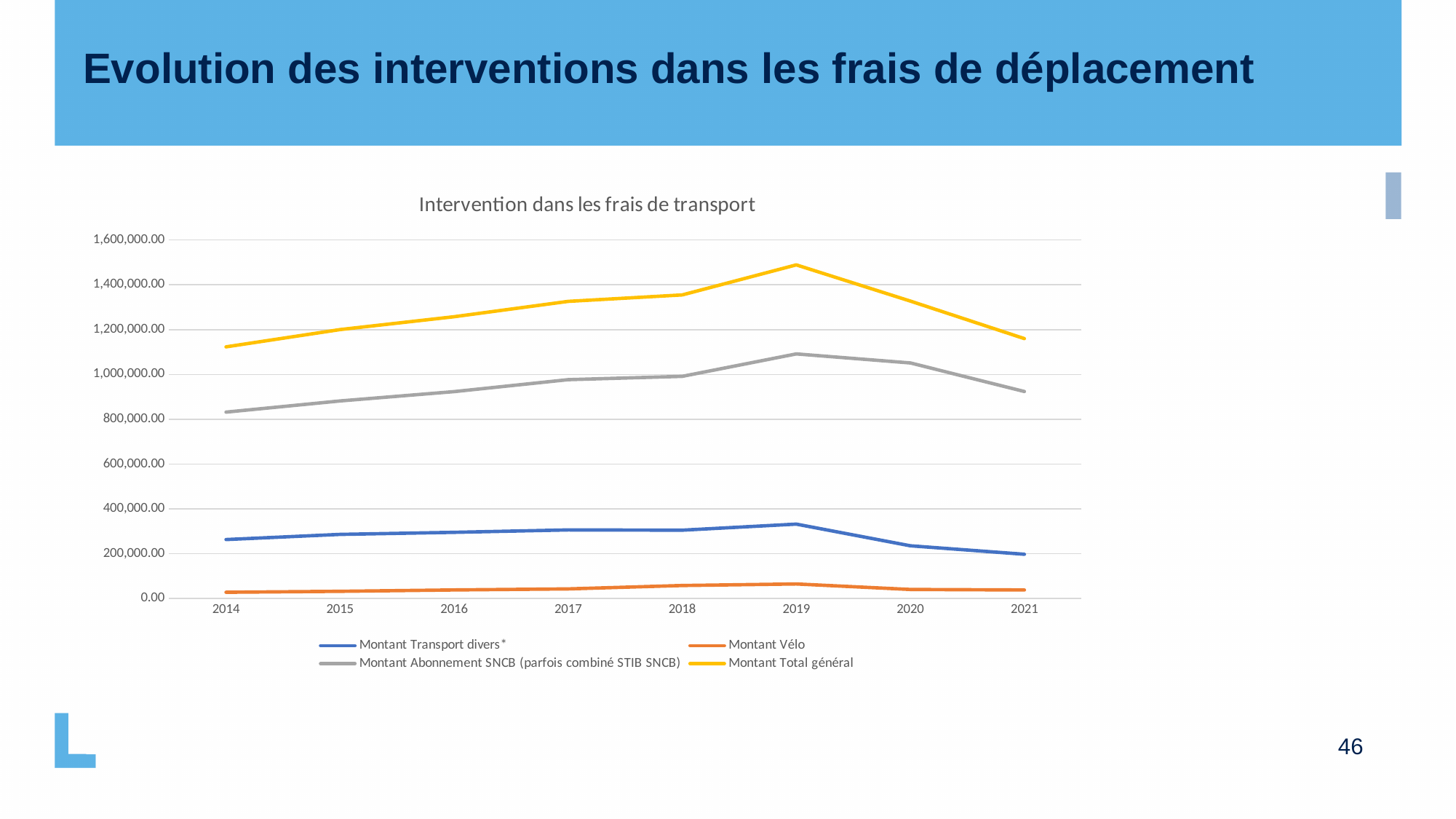
How many series does the legend list? 4 Is the value for Montant Total général in 2019 greater or less than 1,400,000.00? greater What is the title of the chart? Intervention dans les frais de transport What kind of chart is shown on the slide? line chart Is the value for Montant Abonnement SNCB (parfois combiné STIB SNCB) in 2019 greater or less than 1,000,000.00? greater In 2018, which is larger: Montant Abonnement SNCB (parfois combiné STIB SNCB) or Montant Transport divers*? Montant Abonnement SNCB (parfois combiné STIB SNCB) How many years are shown on the x axis? 8 Does Montant Total général rise or fall from 2019 to 2021? fall In which year does Montant Abonnement SNCB (parfois combiné STIB SNCB) reach its highest value? 2019 Is the value for Montant Total général in 2014 greater or less than 1,200,000.00? less In which year does Montant Total général reach its highest value? 2019